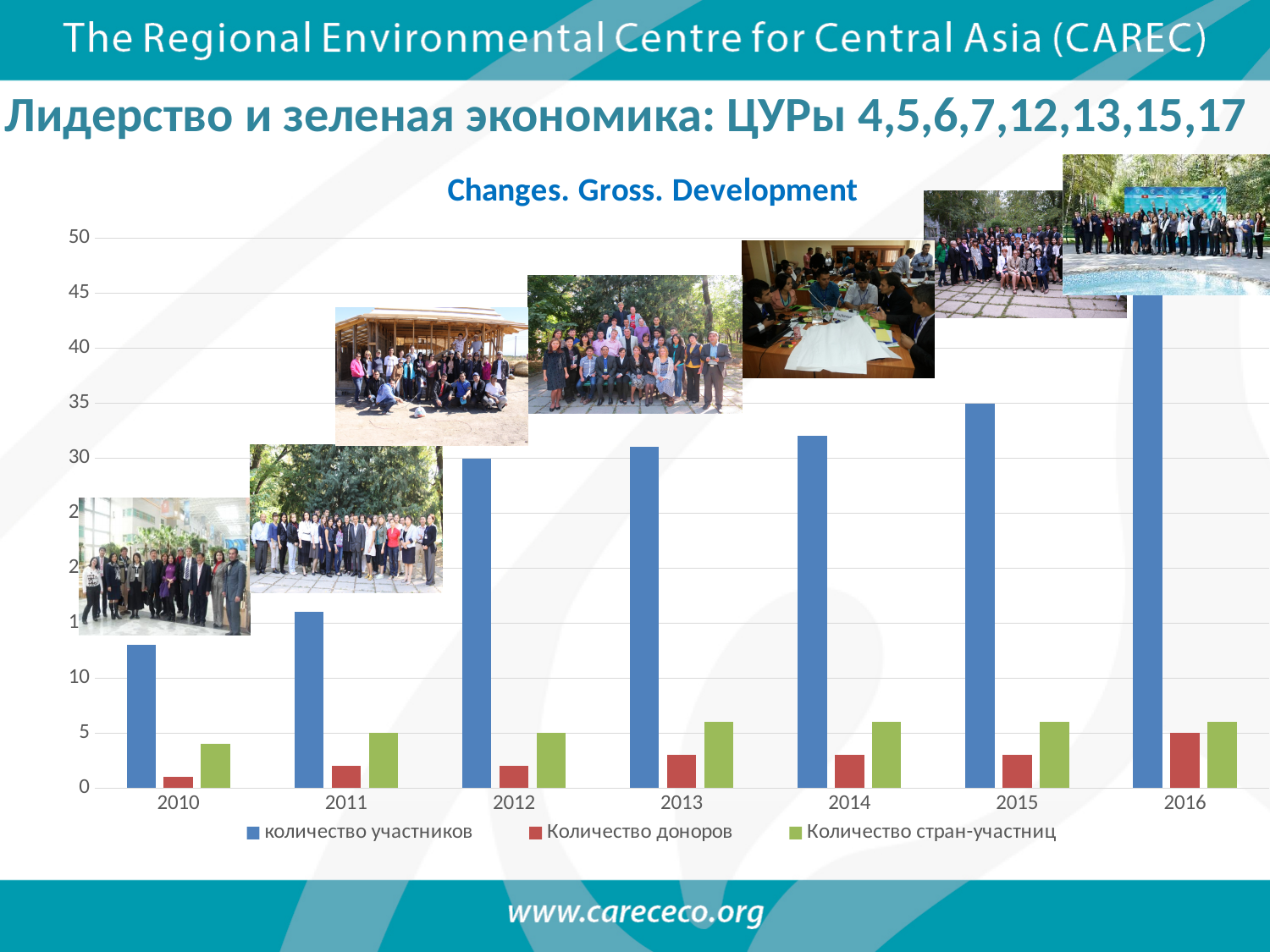
How many series does the chart legend list? 3 Which is larger in 2010: Количество доноров or Количество стран-участниц? Количество стран-участниц How many years are shown on the x axis of the chart? 7 Do the values for количество участников rise or fall from 2010 to 2016? rise What kind of chart is shown on the slide? bar chart What is the value for количество участников in 2016? 45 Is the value for Количество доноров in 2016 greater or less than 10? less Which year has the highest value for количество участников? 2016 Is the value for количество участников in 2010 greater or less than 15? less Is the value for количество участников in 2014 greater or less than 30? greater What is the value for количество участников in 2015? 35 Which year has the lowest value for количество участников? 2010